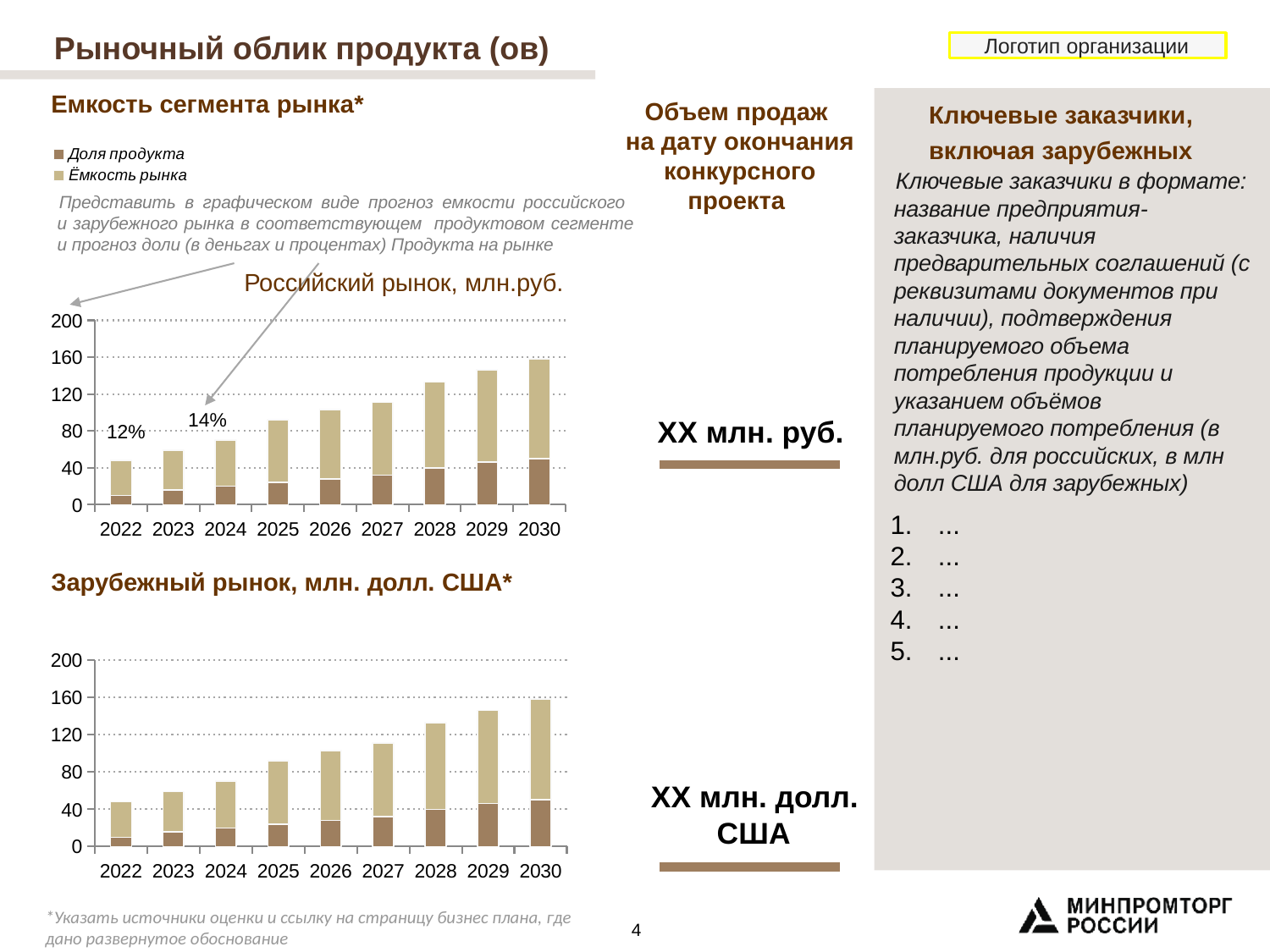
What kind of chart is the 'Российский рынок, млн.руб.' chart? Stacked bar chart In the 'Российский рынок, млн.руб.' chart, is the total bar for 2022 greater or less than 80? less How many years are shown on the x axis of the 'Зарубежный рынок, млн. долл. США*' chart? 9 In the 'Зарубежный рынок, млн. долл. США*' chart, is the total bar for 2023 greater or less than 80? less How many series does the legend list for the market capacity charts? 2 In the 'Российский рынок, млн.руб.' chart, do the bar totals rise or fall from 2022 to 2030? Rise In the 'Российский рынок, млн.руб.' chart, which year has the shortest bar? 2022 What are the two legend entries shown above the market capacity charts? Доля продукта; Ёмкость рынка In the 'Российский рынок, млн.руб.' chart, is the total bar for 2030 greater or less than 120? greater In the 'Зарубежный рынок, млн. долл. США*' chart, which bar is taller, 2025 or 2028? 2028 In the 'Российский рынок, млн.руб.' chart, which year has the tallest bar? 2030